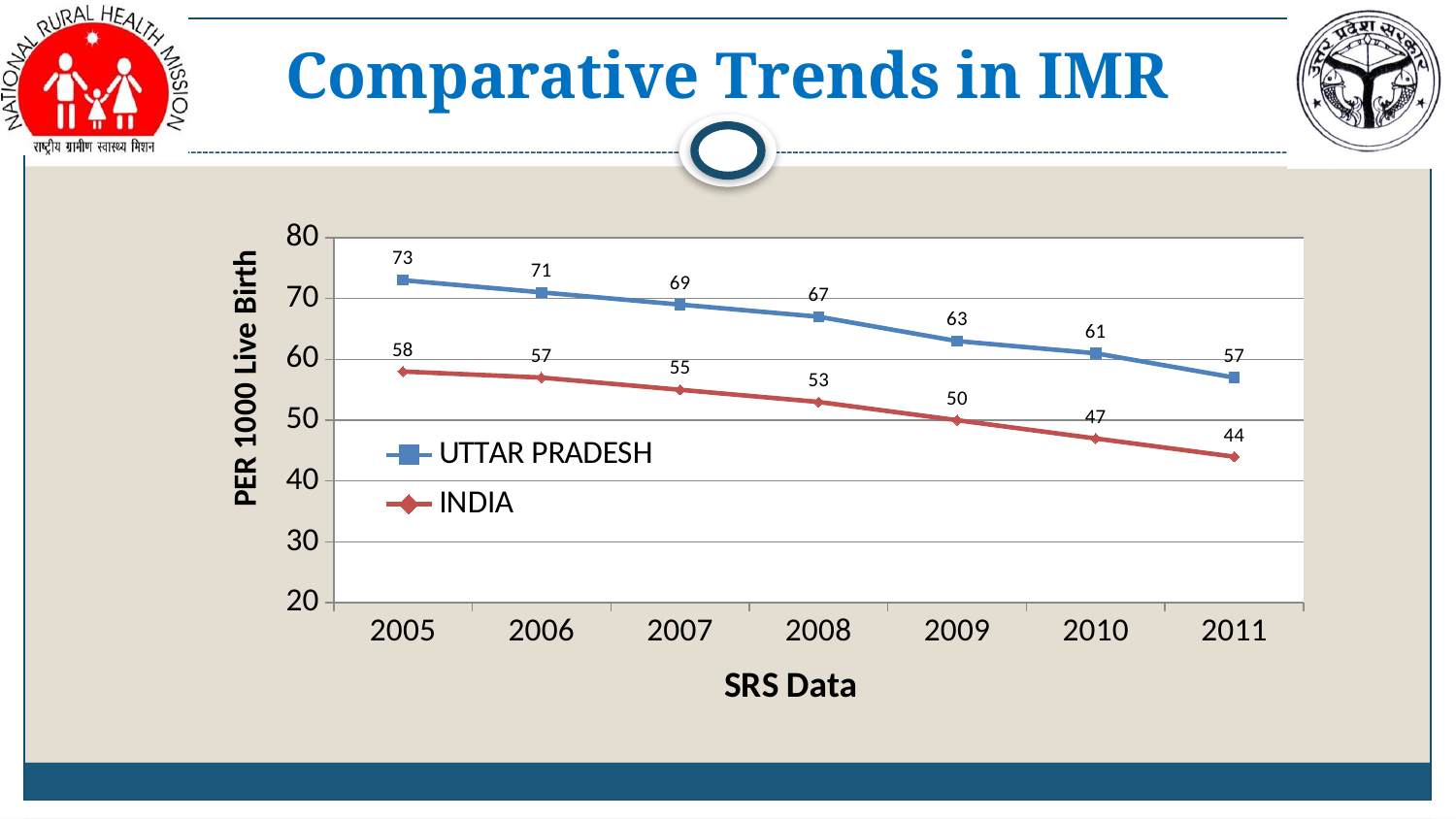
What is the IMR value for Uttar Pradesh in 2005? 73 In which year is the Uttar Pradesh IMR value lowest? 2011 How many series does the legend list? 2 In which year is the India IMR value highest? 2005 What is the IMR value for India in 2011? 44 What is the difference between the Uttar Pradesh and India IMR values in 2011? 13 What is the IMR value for India in 2008? 53 How many years are shown on the x axis? 7 Which series has the larger value in 2007, Uttar Pradesh or India? Uttar Pradesh What is the IMR value for Uttar Pradesh in 2009? 63 What kind of chart is shown on the slide? Line chart Do the Uttar Pradesh IMR values rise or fall from 2005 to 2011? Fall